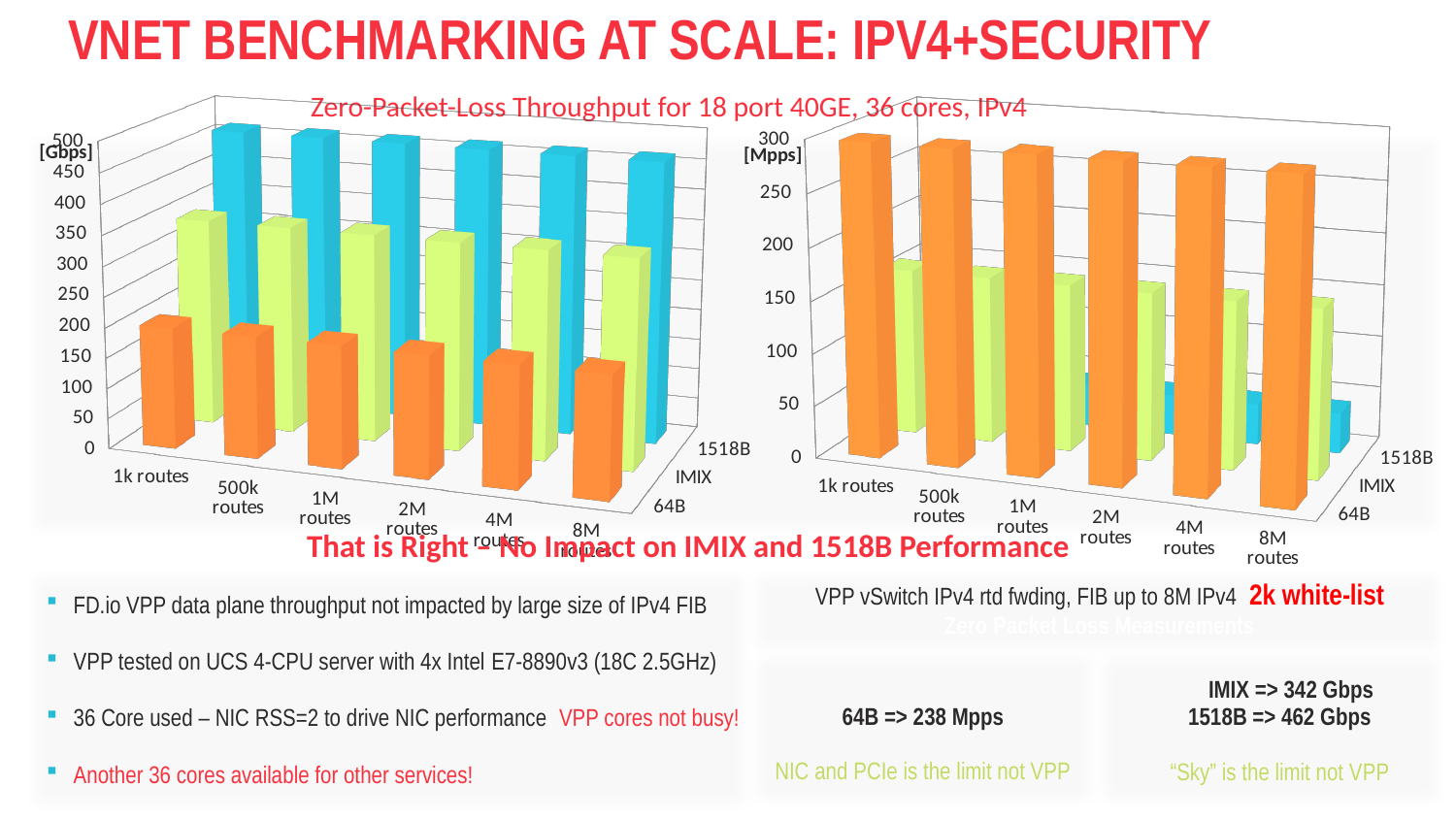
How many series are plotted in the right chart? 3 In the right chart, which is larger at 1k routes: 64B or IMIX? 64B How many route-count categories are shown on the x axis of the left chart? 6 In the right chart, is the value for 1518B at 8M routes greater or less than 100? less What type of chart is the left chart on the slide? bar chart In the right chart, which series has the lowest value at 1k routes? 1518B In the left chart, is the value for 1518B at 1k routes greater or less than 400? greater In the left chart, which series has the highest value at 1k routes? 1518B What unit is shown on the vertical axis of the right chart? [Mpps] In the right chart, is the value for 64B at 1k routes greater or less than 200? greater